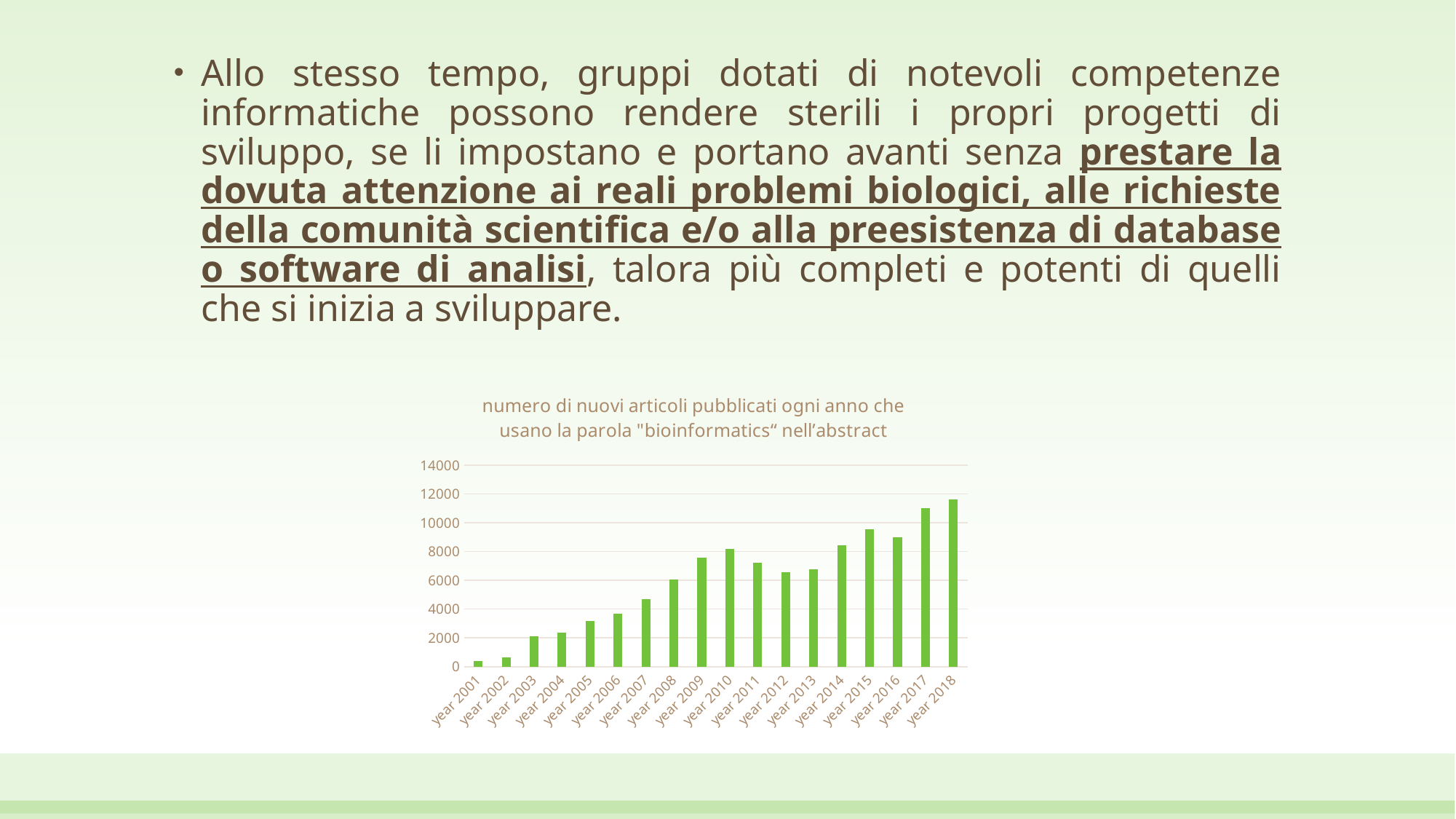
Is the value for year 2001 greater or less than 2000? less Is the value for year 2018 greater or less than 10000? greater Is the value for year 2015 greater or less than 8000? greater Overall, do the values rise or fall from year 2001 to year 2018? rise Which year has the highest number of new articles? year 2018 Which year has a higher value, year 2010 or year 2011? year 2010 What kind of chart is shown on the slide? bar chart What word in the abstract does the chart title say the counted articles use? bioinformatics Which year has the lowest number of new articles? year 2001 How many years (bars) are shown in the chart? 18